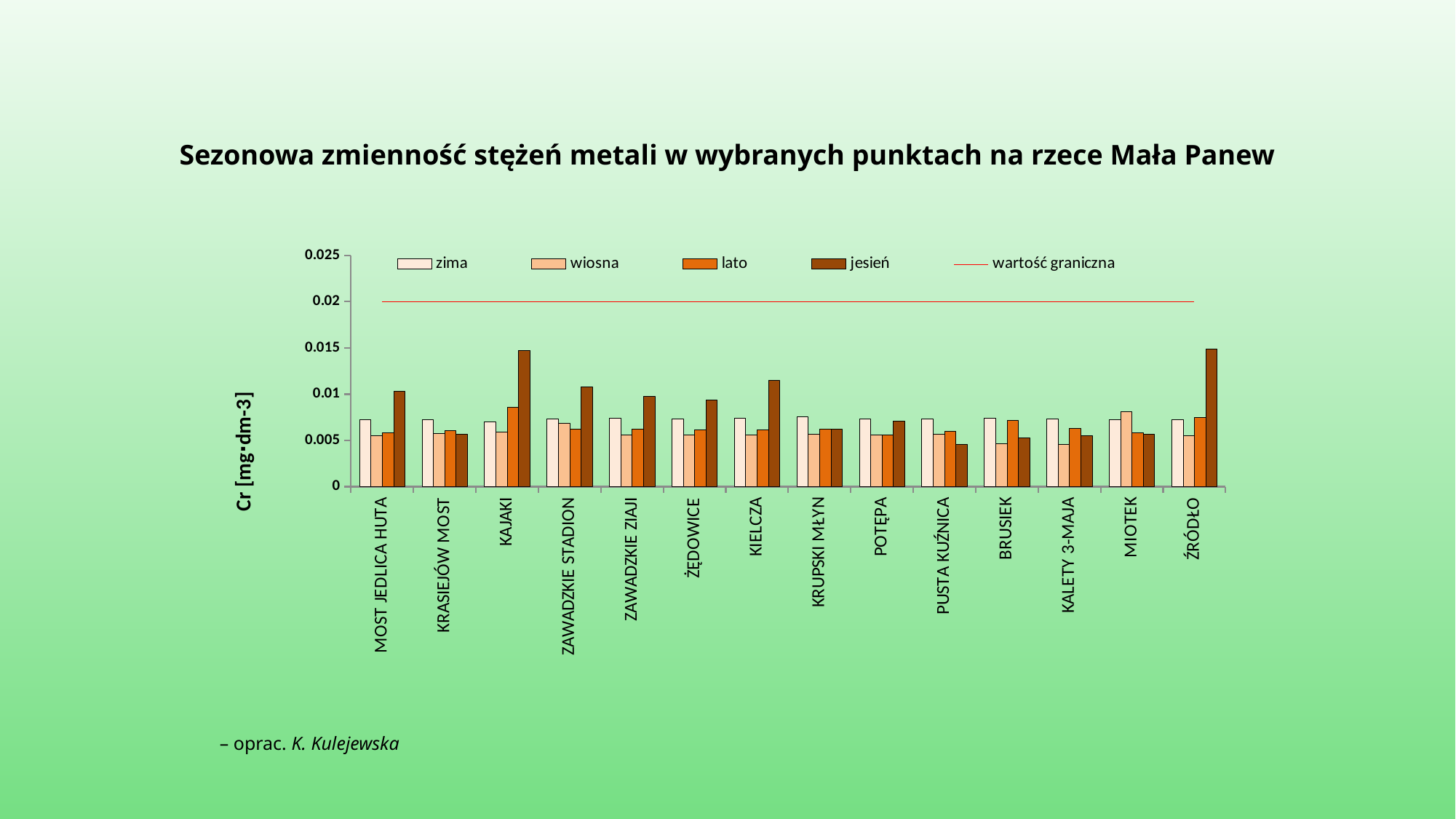
Which site has the lowest jesień value? PUSTA KUŹNICA How many sampling sites (categories) are shown on the x axis? 14 Is the jesień value for KAJAKI greater or less than 0.01? greater Is the wiosna value for PUSTA KUŹNICA greater or less than 0.01? less Is the zima value for MOST JEDLICA HUTA greater or less than 0.005? greater What is the label on the y axis? Cr [mg·dm-3] What kind of chart is shown on the slide? bar chart How many entries does the legend list? 5 What value does the red 'wartość graniczna' line sit at on the y axis? 0.02 At KIELCZA, which is larger: the zima value or the jesień value? jesień What is the title of the chart? Sezonowa zmienność stężeń metali w wybranych punktach na rzece Mała Panew